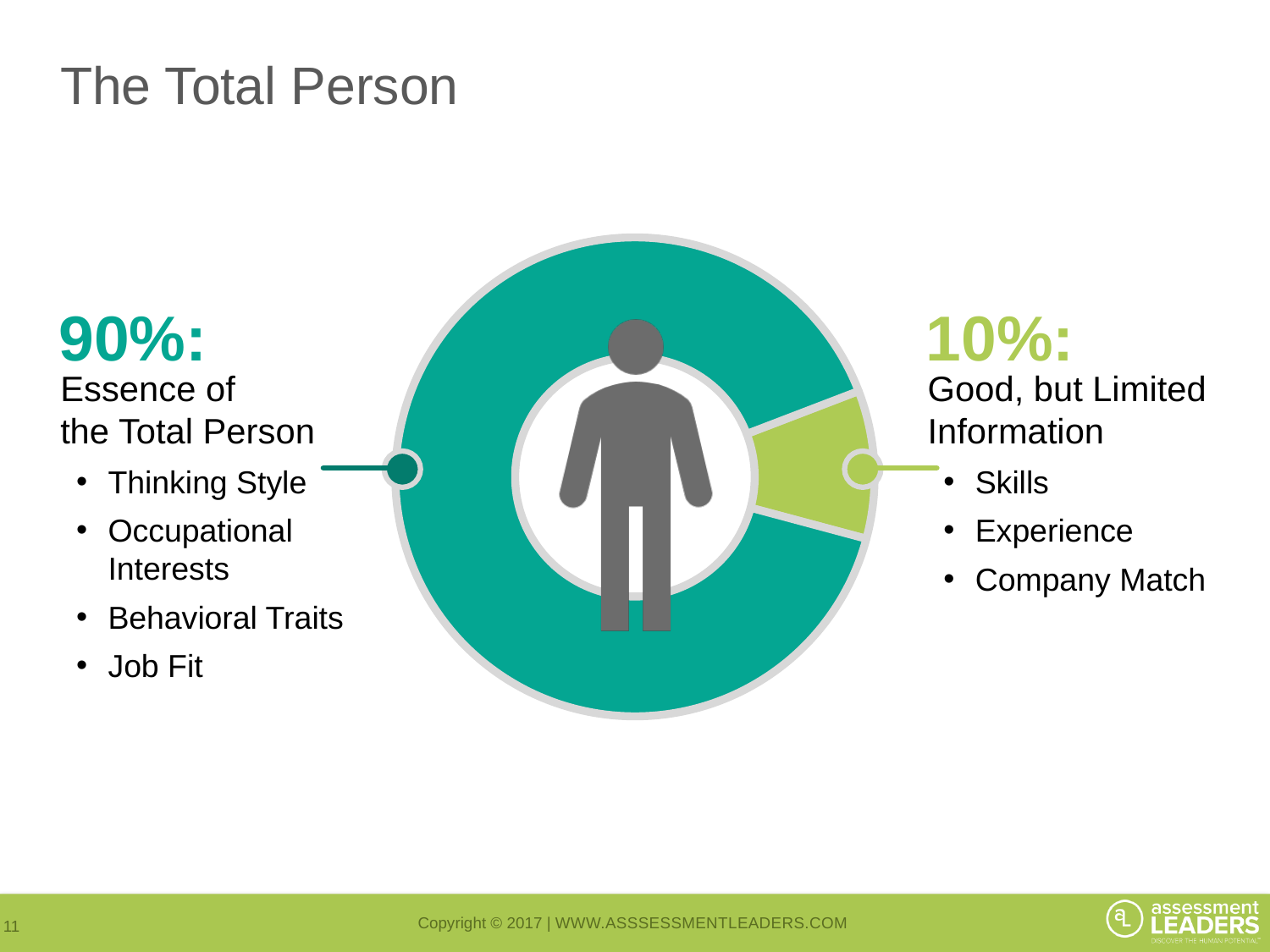
What is the total of the two segments shown in the donut chart? 100% Which items are listed under the 10% segment of the donut chart? Skills, Experience, Company Match Which is larger: the "Essence of the Total Person" segment or the "Good, but Limited Information" segment? Essence of the Total Person What kind of chart is shown on the slide? Donut chart What share of the donut chart is labeled "Essence of the Total Person"? 90% What colour is the 10% segment of the donut chart? Light green What is the difference in percentage points between the "Essence of the Total Person" segment and the "Good, but Limited Information" segment? 80 percentage points Which segment of the donut chart is the largest? Essence of the Total Person How many segments does the donut chart have? 2 What is the title of the slide containing the donut chart? The Total Person What share of the donut chart is labeled "Good, but Limited Information"? 10% Which segment of the donut chart is the smallest? Good, but Limited Information